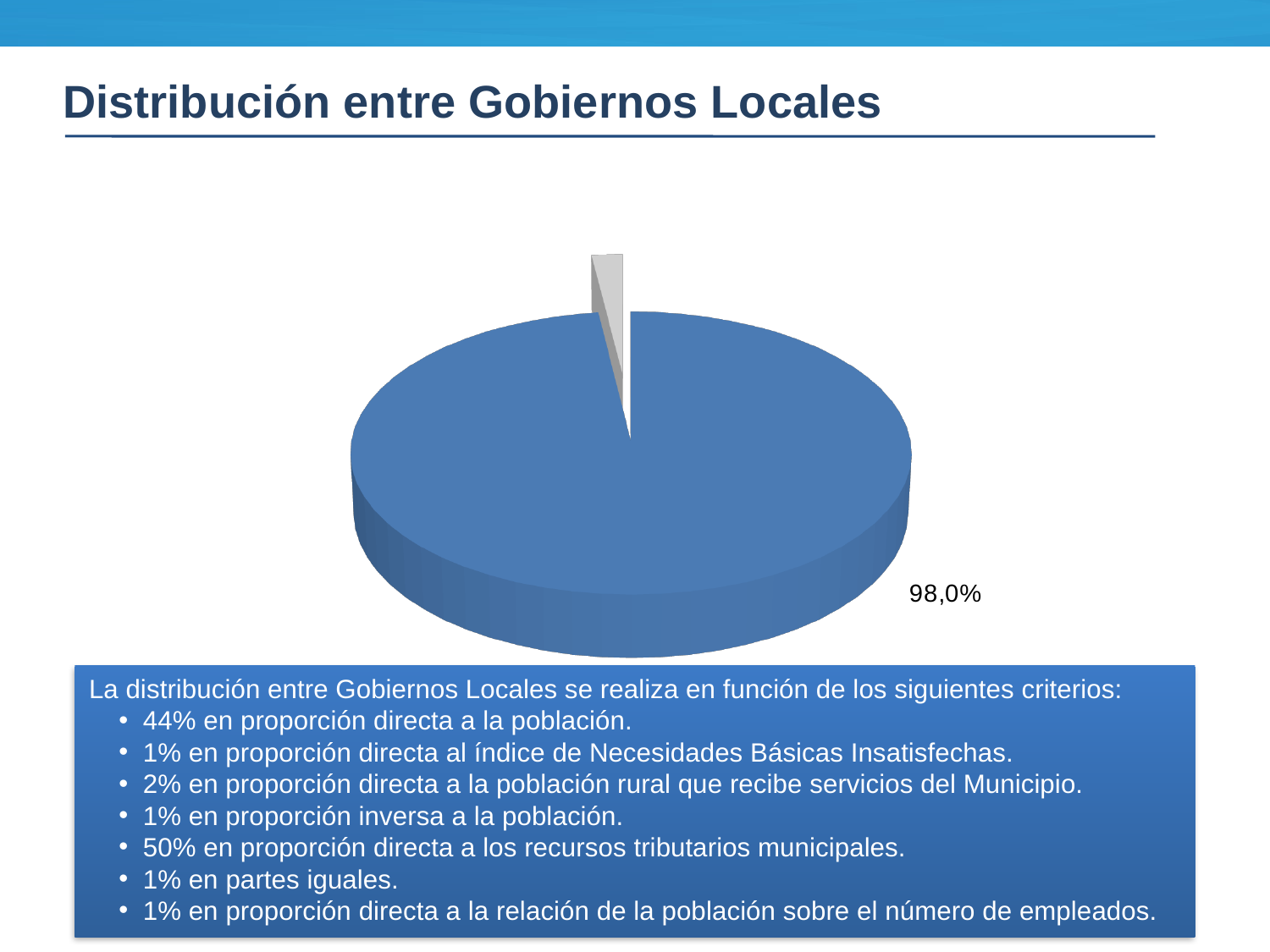
Which slice of the pie chart is the largest, the blue one or the grey one? the blue one What share of the pie does the blue slice represent? 98,0% Which slice of the pie chart is the smallest, the blue one or the grey one? the grey one What colour is the slice labelled 98,0%? blue What kind of chart is shown on the slide? pie chart Is the blue slice larger or smaller than the grey slice? larger How many slices does the pie chart have? 2 Does the pie chart include a legend? No What value is printed on the large blue slice of the pie chart? 98,0%